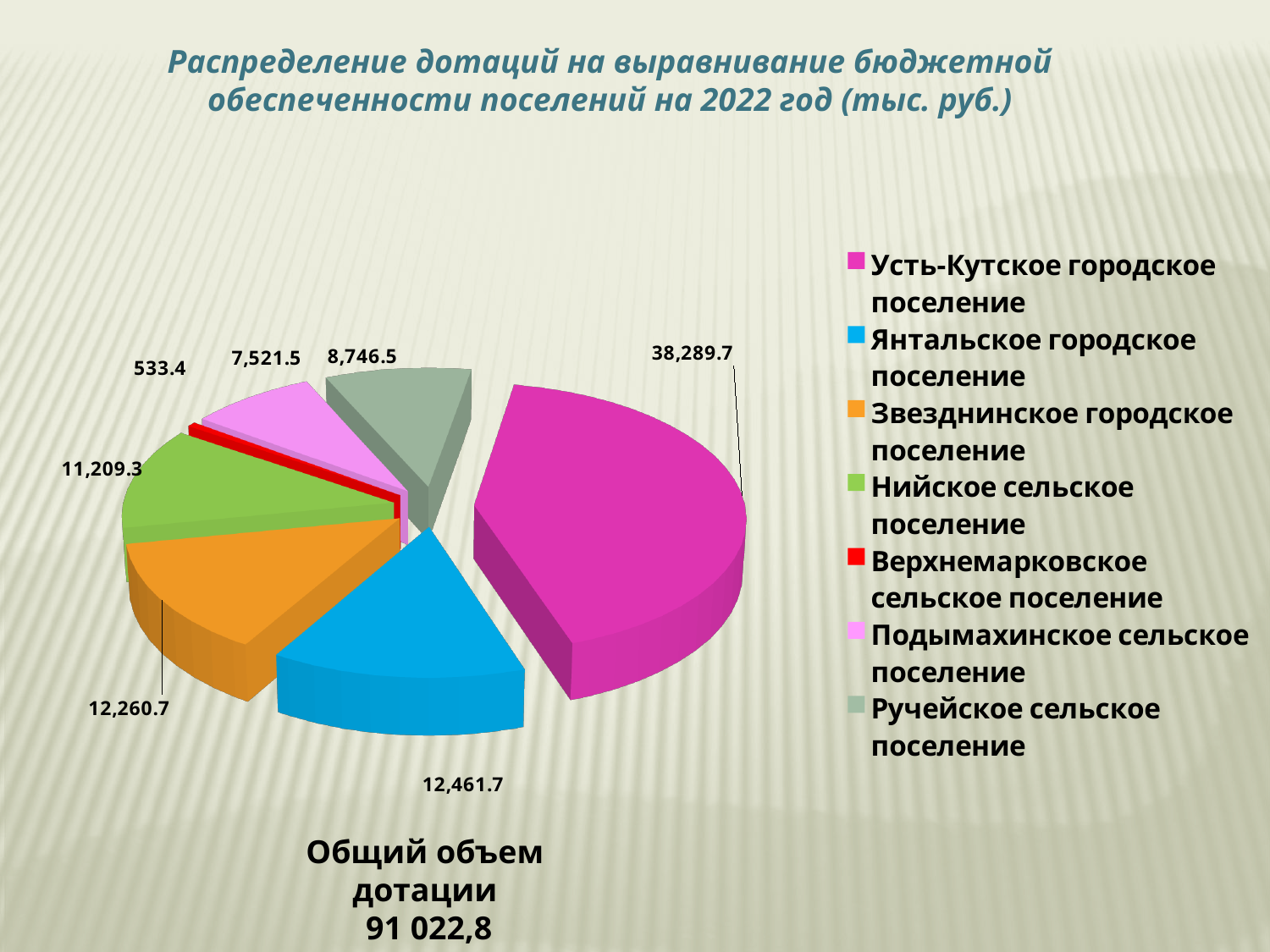
Which is larger: the value for Ручейское сельское поселение or Подымахинское сельское поселение? Ручейское сельское поселение Which settlement receives the smallest share of the subsidy? Верхнемарковское сельское поселение How many settlements are listed in the legend? 7 What is the value for Ручейское сельское поселение? 8,746.5 What is the value for Усть-Кутское городское поселение? 38,289.7 What is the value for Янтальское городское поселение? 12,461.7 Which settlement receives the largest share of the subsidy? Усть-Кутское городское поселение What is the value for Звезднинское городское поселение? 12,260.7 What is the value for Верхнемарковское сельское поселение? 533.4 What is the value for Нийское сельское поселение? 11,209.3 What is the difference between the values for Янтальское городское поселение and Звезднинское городское поселение? 201.0 What type of chart is shown on the slide? Pie chart